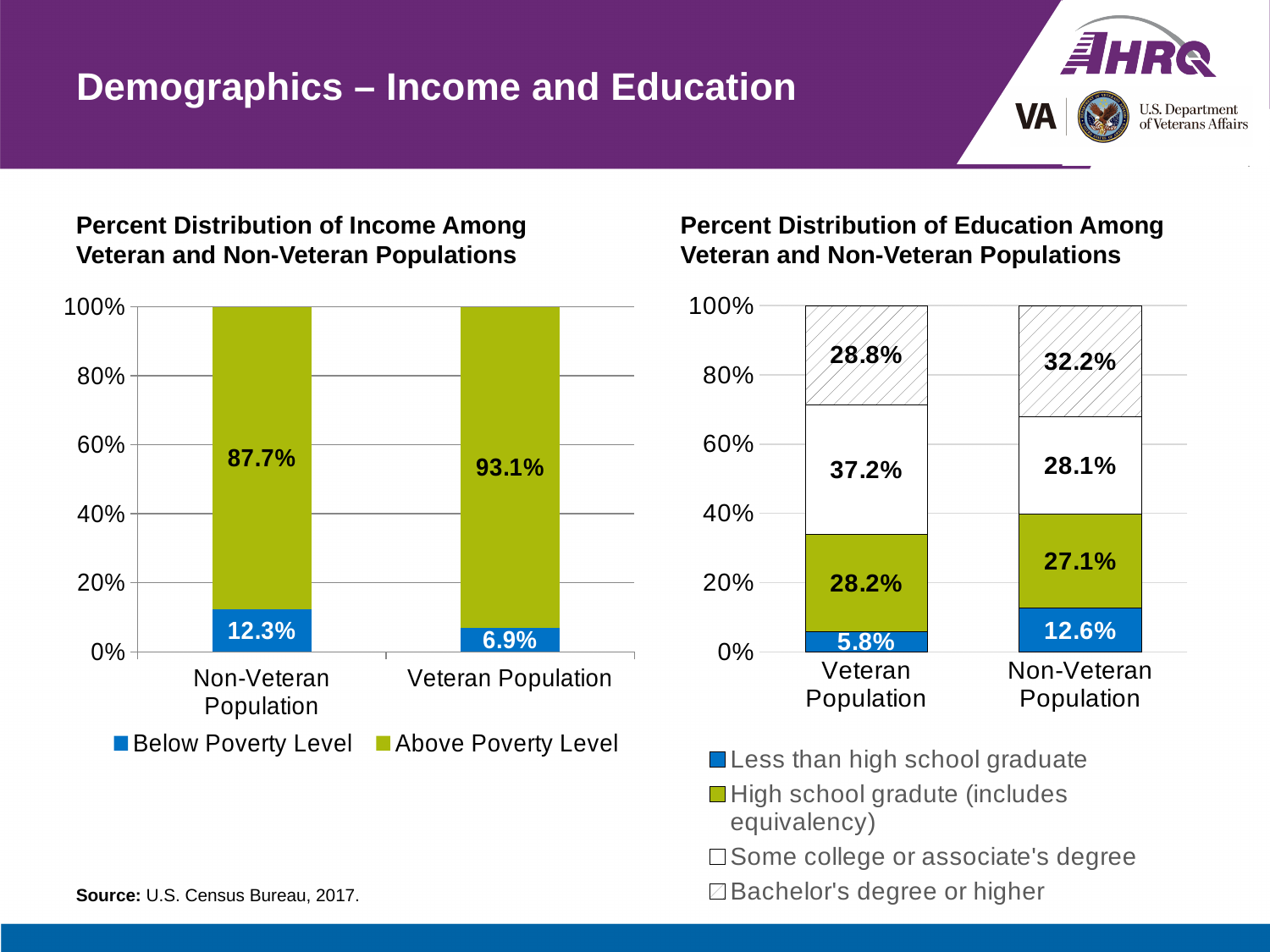
In the education chart, which education level is the smallest segment for the Non-Veteran Population? Less than high school graduate In the education chart, what is the difference between the Some college or associate's degree shares of the Veteran Population and the Non-Veteran Population? 9.1% In the income chart, which population has the larger Below Poverty Level share, Non-Veteran Population or Veteran Population? Non-Veteran Population In the income chart, what percentage of the Non-Veteran Population is Below Poverty Level? 12.3% In the education chart, what percentage of the Non-Veteran Population is Less than high school graduate? 12.6% In the income chart, what percentage of the Veteran Population is Above Poverty Level? 93.1% In the income chart, what is the difference between the Above Poverty Level shares of the Veteran Population and the Non-Veteran Population? 5.4% In the income chart, how many series does the legend list? 2 In the education chart, which education level is the largest segment for the Veteran Population? Some college or associate's degree In the education chart, what percentage of the Veteran Population has a Bachelor's degree or higher? 28.8% In the education chart, how many series does the legend list? 4 What kind of chart is the education chart? Stacked bar chart